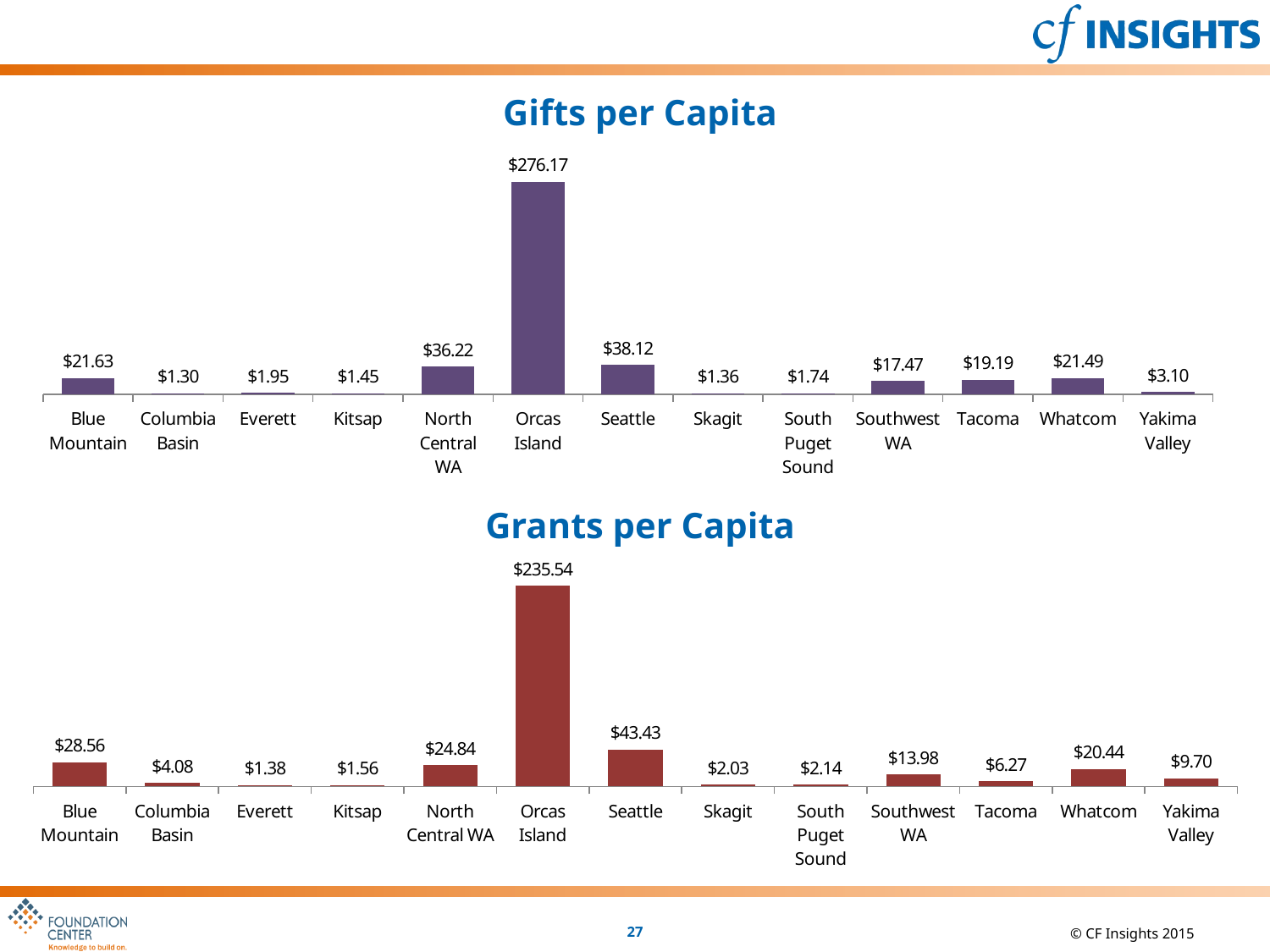
In the Grants per Capita chart, which community has the lowest value? Everett In the Gifts per Capita chart, which community has the lowest value? Columbia Basin How many communities are shown in the Grants per Capita chart? 13 In the Grants per Capita chart, what is the difference between Seattle and Blue Mountain? $14.87 In the Gifts per Capita chart, what is the value for Orcas Island? $276.17 In the Grants per Capita chart, what is the value for Seattle? $43.43 In the Grants per Capita chart, what is the value for Yakima Valley? $9.70 What type of chart is the Gifts per Capita chart? Bar chart What is the difference between Orcas Island's Gifts per Capita and its Grants per Capita? $40.63 In the Gifts per Capita chart, which community has the highest value? Orcas Island In the Gifts per Capita chart, what is the value for Southwest WA? $17.47 In the Gifts per Capita chart, which is larger: Seattle or North Central WA? Seattle